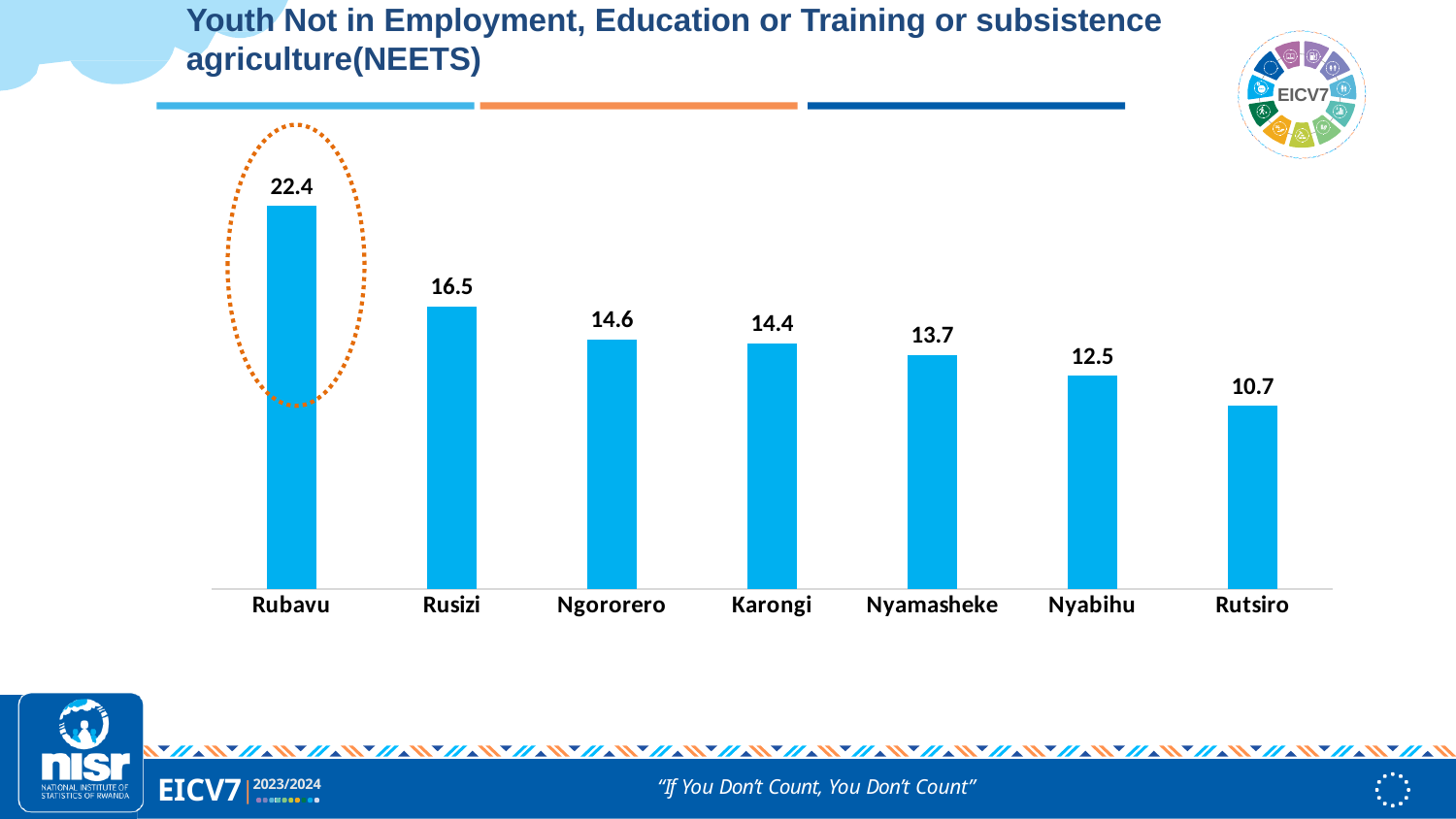
What kind of chart is shown on the slide? Bar chart What is the NEETS value for Rutsiro? 10.7 Which district's bar is circled with a dotted orange outline? Rubavu Which district has the highest NEETS value? Rubavu Which district has the lowest NEETS value? Rutsiro Do the NEETS values rise or fall from left to right across the districts? Fall What is the NEETS value for Rubavu? 22.4 What is the difference between the NEETS values for Nyabihu and Rutsiro? 1.8 Which has a larger NEETS value, Ngororero or Nyabihu? Ngororero What is the NEETS value for Nyamasheke? 13.7 What is the difference between the NEETS values for Rubavu and Rusizi? 5.9 How many districts are shown in the chart? 7